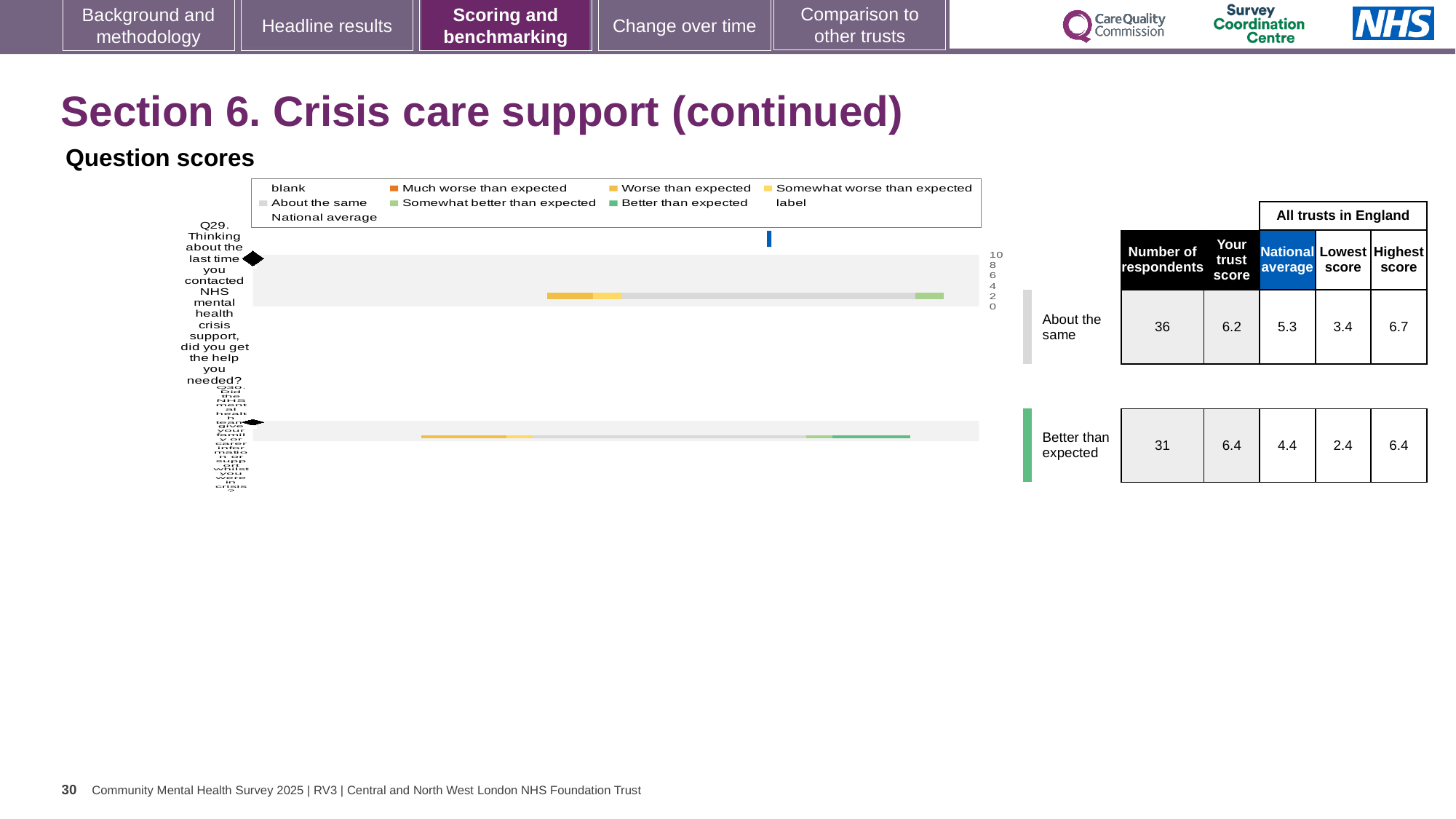
Which benchmark category is Q30 placed in? Better than expected What is the difference between the trust score and the national average for Q29? 0.9 How many questions are plotted in the question scores chart? 2 Which two questions are shown in the question scores chart? Q29 and Q30 By how much does the trust score for Q30 exceed the national average for Q30? 2.0 What is the trust score for Q29 (did you get the help you needed from NHS mental health crisis support)? 6.2 What is the highest score across all trusts in England for Q30? 6.4 What kind of chart is used to show the question scores on this slide? bar chart What is the lowest score across all trusts in England for Q29? 3.4 What is the national average score for Q30 (did the NHS mental health team give your family or carer information or support whilst you were in crisis)? 4.4 How many respondents answered Q29? 36 Which question has the higher trust score, Q29 or Q30? Q30